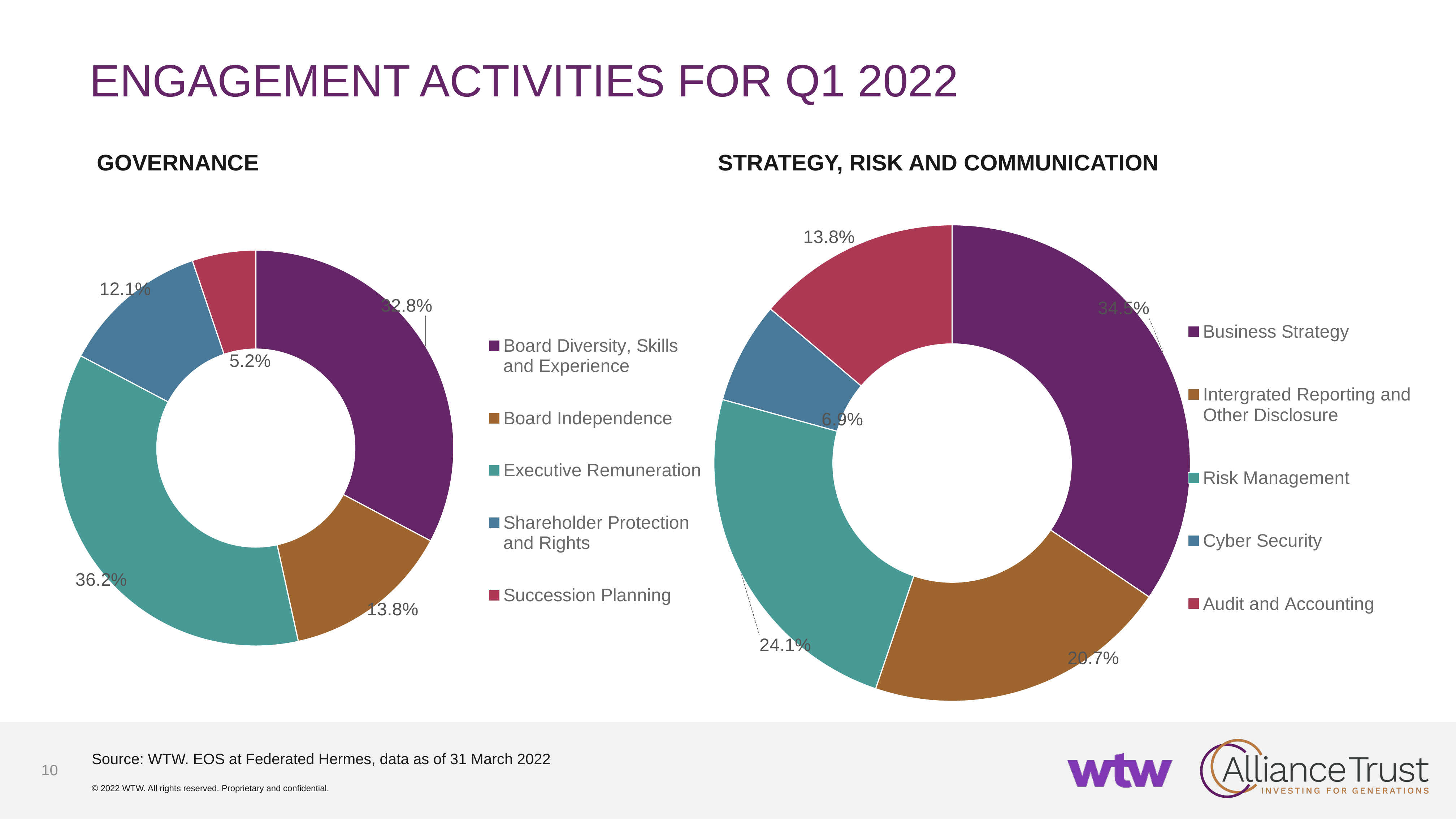
In the Governance chart, which category has the smallest share? Succession Planning In the Governance chart, which category has the largest share? Executive Remuneration In the Governance chart, what share does Executive Remuneration have? 36.2% How many categories does the legend of the Governance chart list? 5 In the Governance chart, what is the difference between the shares of Board Independence and Shareholder Protection and Rights? 1.7% In the Strategy, Risk and Communication chart, what share does Cyber Security have? 6.9% In the Strategy, Risk and Communication chart, what share does Risk Management have? 24.1% What kind of chart is the Strategy, Risk and Communication chart? Donut (pie) chart In the Governance chart, what share does Succession Planning have? 5.2% In the Strategy, Risk and Communication chart, which is larger: Intergrated Reporting and Other Disclosure or Audit and Accounting? Intergrated Reporting and Other Disclosure In the Strategy, Risk and Communication chart, what is the difference between the shares of Business Strategy and Risk Management? 10.4% In the Strategy, Risk and Communication chart, which category has the largest share? Business Strategy